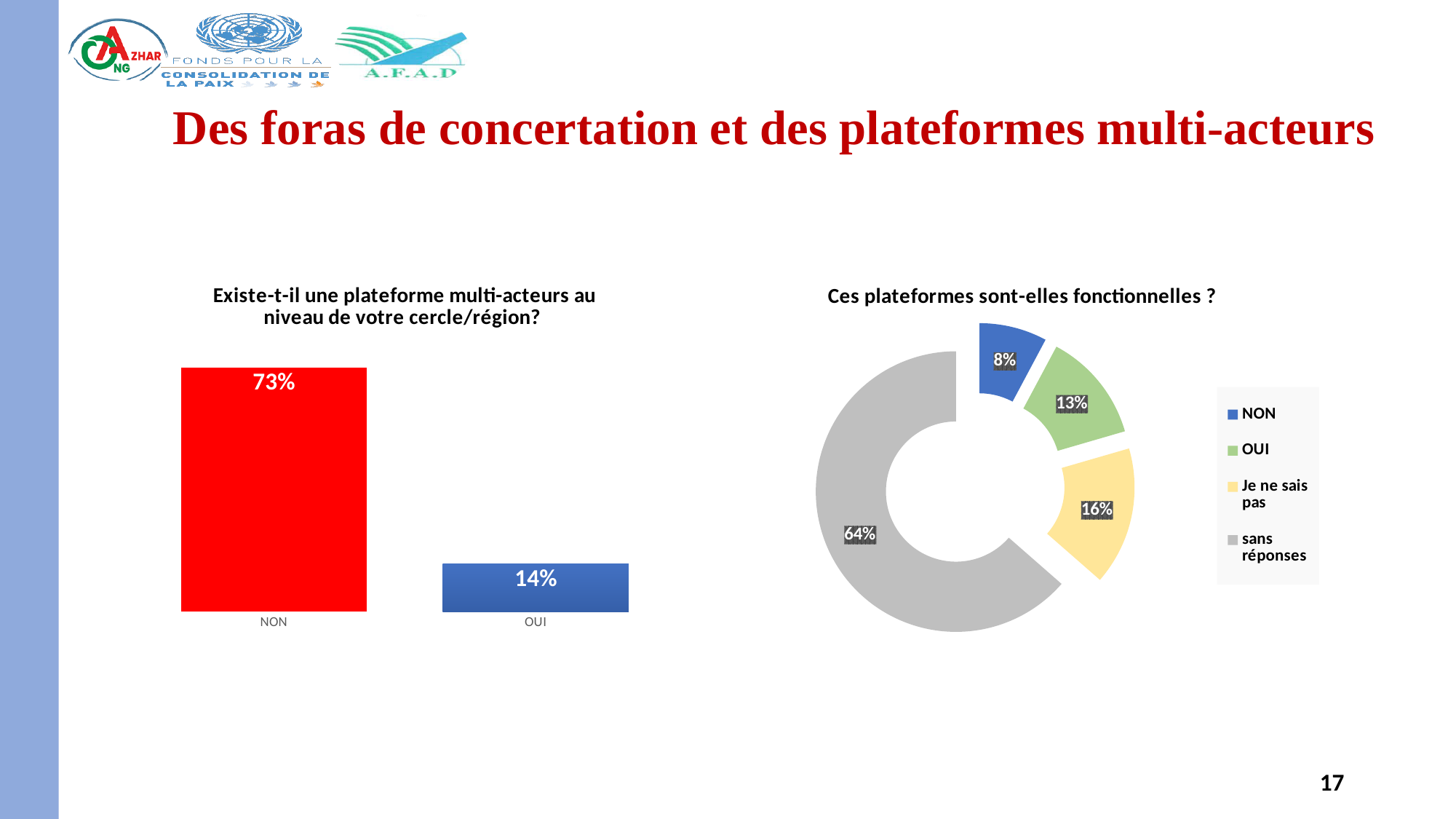
In the right chart 'Ces plateformes sont-elles fonctionnelles ?', what colour is the 'Je ne sais pas' slice? Yellow In the left chart 'Existe-t-il une plateforme multi-acteurs au niveau de votre cercle/région?', which category has the highest value? NON In the right chart 'Ces plateformes sont-elles fonctionnelles ?', which is larger: OUI or NON? OUI What kind of chart is the left chart 'Existe-t-il une plateforme multi-acteurs au niveau de votre cercle/région?'? Bar chart How many categories are shown in the left chart 'Existe-t-il une plateforme multi-acteurs au niveau de votre cercle/région?'? 2 How many categories does the legend of the right chart 'Ces plateformes sont-elles fonctionnelles ?' list? 4 In the left chart 'Existe-t-il une plateforme multi-acteurs au niveau de votre cercle/région?', what is the value for NON? 73% In the right chart 'Ces plateformes sont-elles fonctionnelles ?', which category has the smallest share? NON In the left chart 'Existe-t-il une plateforme multi-acteurs au niveau de votre cercle/région?', what is the difference between NON and OUI? 59% In the left chart 'Existe-t-il une plateforme multi-acteurs au niveau de votre cercle/région?', what is the value for OUI? 14% In the right chart 'Ces plateformes sont-elles fonctionnelles ?', what is the share for 'Je ne sais pas'? 16% In the right chart 'Ces plateformes sont-elles fonctionnelles ?', what is the share for 'sans réponses'? 64%